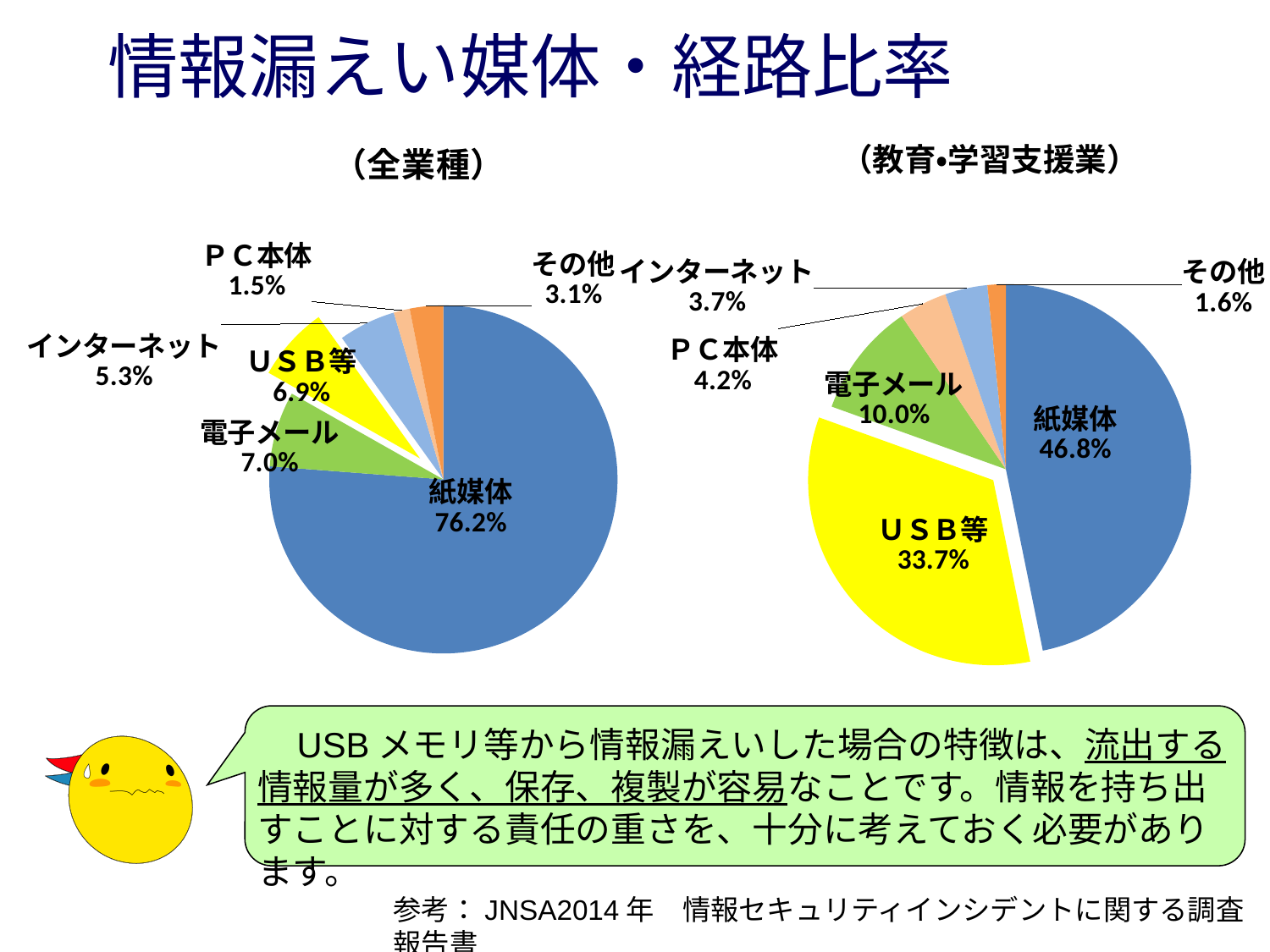
What is the difference between the 紙媒体 share in the 全業種 chart and the 紙媒体 share in the 教育・学習支援業 chart? 29.4% In the 教育・学習支援業 pie chart on the right, what share does ＵＳＢ等 have? 33.7% In the 教育・学習支援業 pie chart on the right, which category has the smallest share? その他 In the 教育・学習支援業 pie chart on the right, what share does 電子メール have? 10.0% How many categories does the 教育・学習支援業 pie chart on the right show? 6 In the 全業種 pie chart on the left, which category has the smallest share? ＰＣ本体 In the 教育・学習支援業 pie chart on the right, what is the difference between the shares of 紙媒体 and ＵＳＢ等? 13.1% In the 全業種 pie chart on the left, what share does 紙媒体 have? 76.2% In the 全業種 pie chart on the left, which category has the largest share? 紙媒体 In the 全業種 pie chart on the left, what share does インターネット have? 5.3% What kind of chart is the 全業種 chart on the left? Pie chart In the 全業種 pie chart on the left, which is larger, 電子メール or ＵＳＢ等? 電子メール